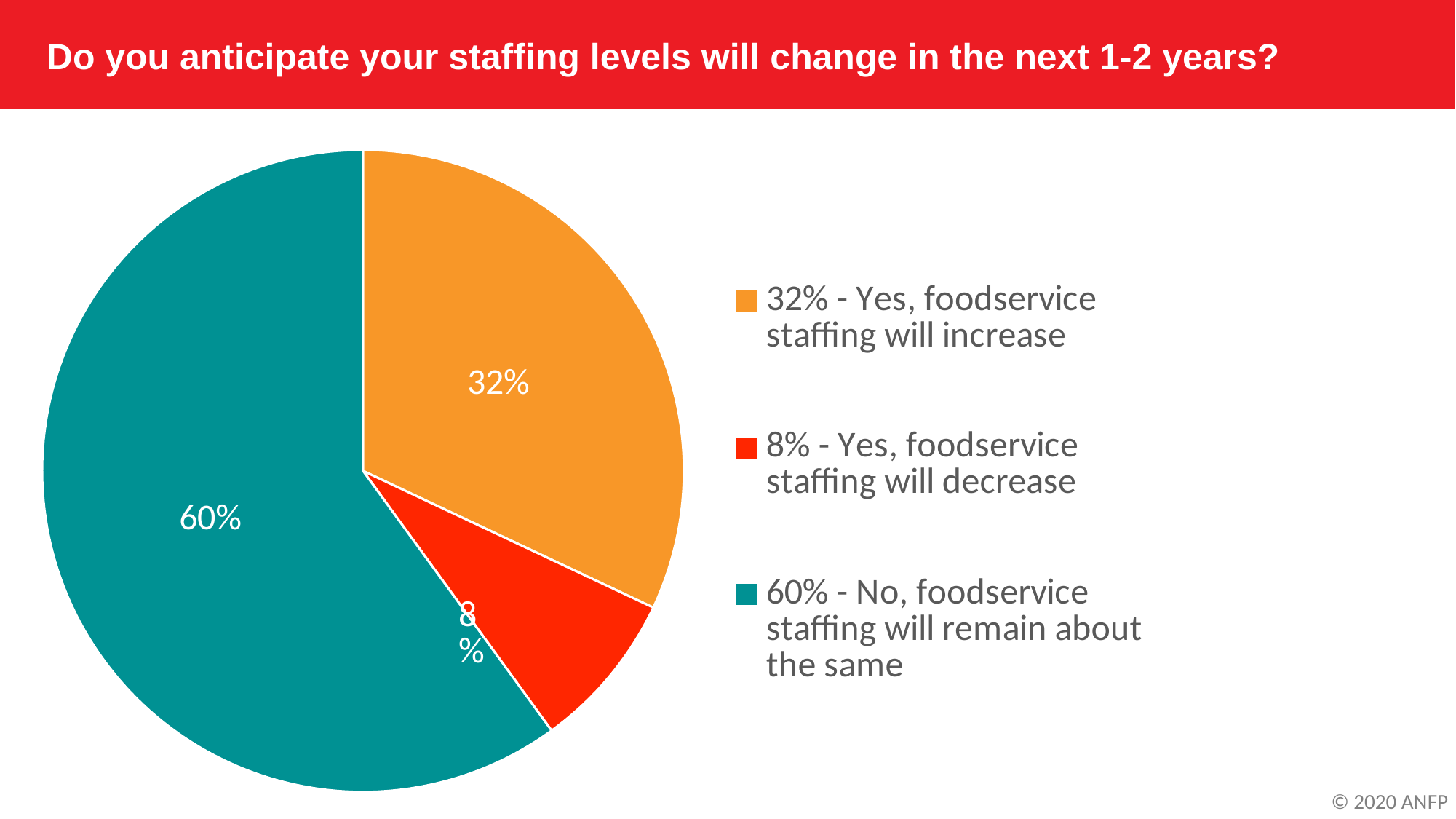
What percentage of respondents said foodservice staffing will decrease? 8% What is the combined share of respondents who expect staffing to change (increase or decrease)? 40% What percentage of respondents said foodservice staffing will increase? 32% What colour is the slice for 'No, foodservice staffing will remain about the same'? teal What is the difference in percentage points between the 'remain about the same' slice and the 'will increase' slice? 28 What is the title of the chart on the slide? Do you anticipate your staffing levels will change in the next 1-2 years? How many slices does the pie chart have? 3 What percentage of respondents said foodservice staffing will remain about the same? 60% Which response has the largest share of the pie? No, foodservice staffing will remain about the same Which response has the smallest share of the pie? Yes, foodservice staffing will decrease Which is larger: the share for 'staffing will increase' or the share for 'staffing will decrease'? staffing will increase What kind of chart is shown on the slide? pie chart